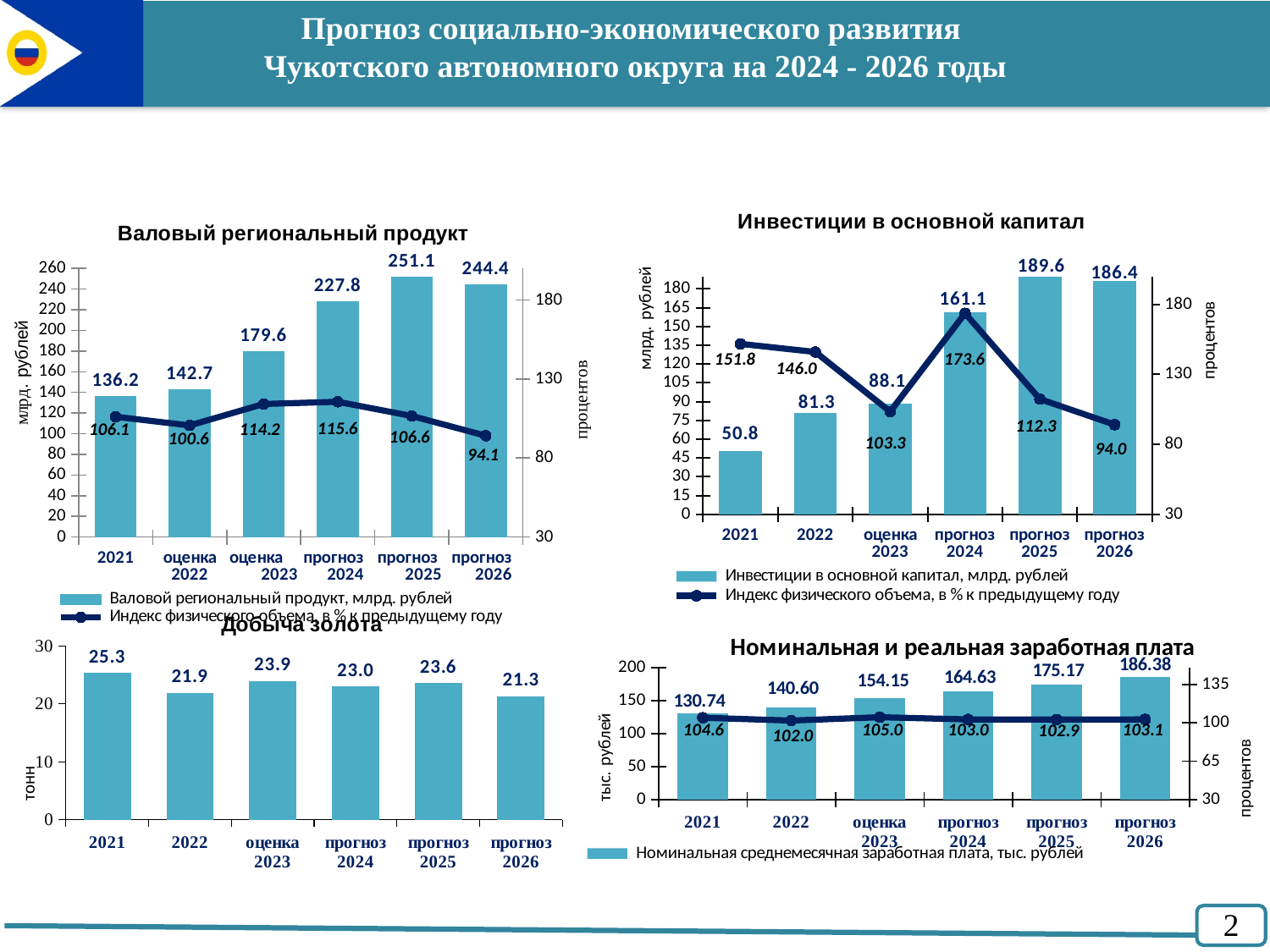
In the chart 'Инвестиции в основной капитал', what is the bar value for прогноз 2024? 161.1 In the chart 'Инвестиции в основной капитал', what is the difference between the bar values for 2022 and 2021? 30.5 What type of chart is 'Добыча золота'? bar chart In the chart 'Инвестиции в основной капитал', which category has the highest bar value? прогноз 2025 In the chart 'Инвестиции в основной капитал', how many series does the legend list? 2 In the chart 'Номинальная и реальная заработная плата', do the bar values rise or fall from 2021 to прогноз 2026? rise In the chart 'Валовый региональный продукт', what is the value of the bar for прогноз 2025? 251.1 In the chart 'Добыча золота', which category has the highest value? 2021 In the chart 'Номинальная и реальная заработная плата', what is the bar value for прогноз 2026? 186.38 In the chart 'Валовый региональный продукт', which category has the lowest bar value? 2021 In the chart 'Валовый региональный продукт', what is the value of the line (Индекс физического объема) for прогноз 2026? 94.1 In the chart 'Добыча золота', what is the value for оценка 2023? 23.9